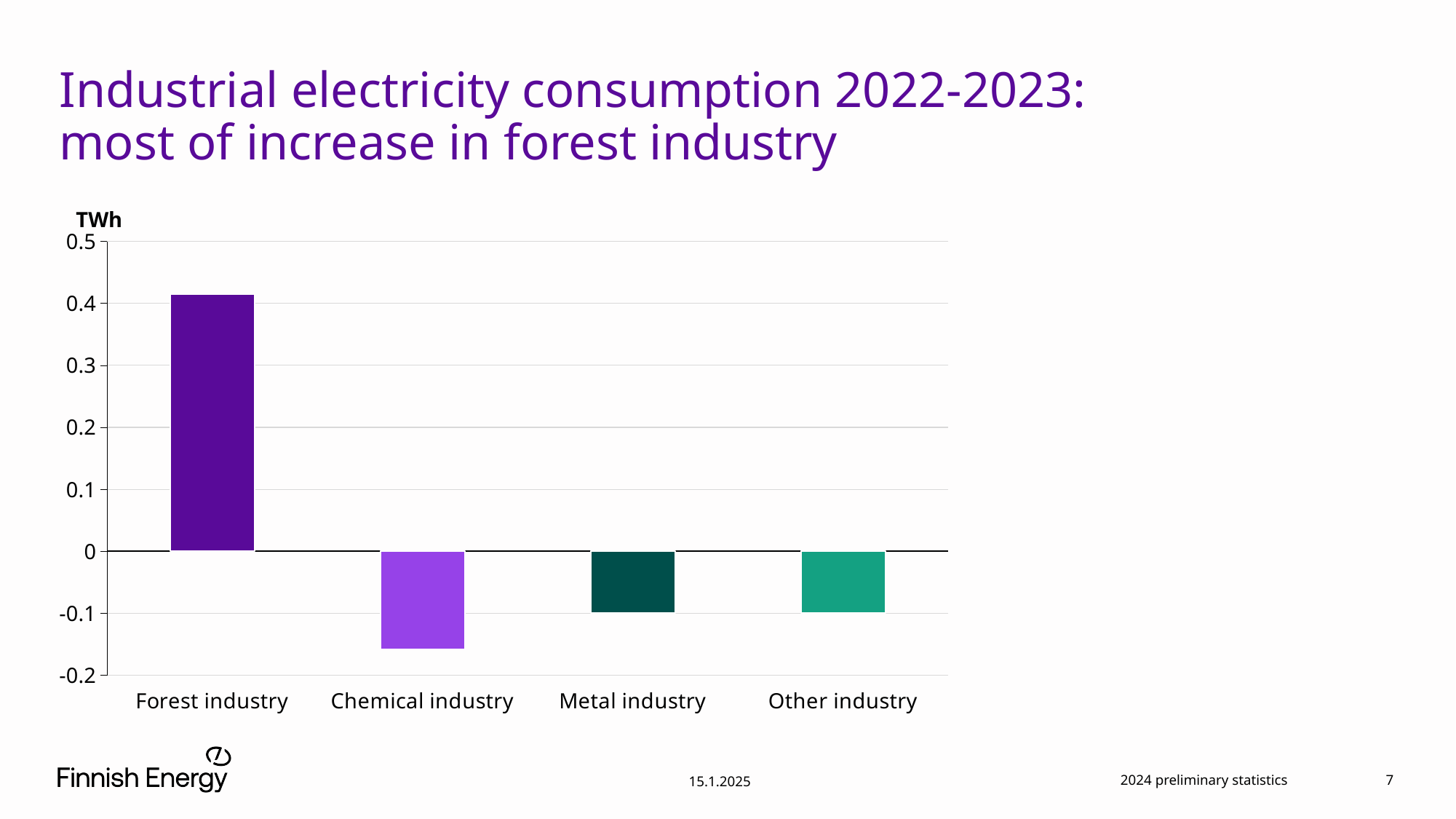
How many industries show a negative change in the chart? 3 Is the value for Chemical industry greater or less than -0.2? greater Is the value for Forest industry greater or less than 0.5? less How many industry categories are shown on the x axis? 4 Is the value for Forest industry greater or less than 0.3? greater What kind of chart is shown on the slide? bar chart Which is larger, the value for Forest industry or the value for Chemical industry? Forest industry Which industry has the lowest value in the chart? Chemical industry What unit is shown on the y axis of the chart? TWh What is the title of the slide containing the chart? Industrial electricity consumption 2022-2023: most of increase in forest industry Which industry has the highest value in the chart? Forest industry